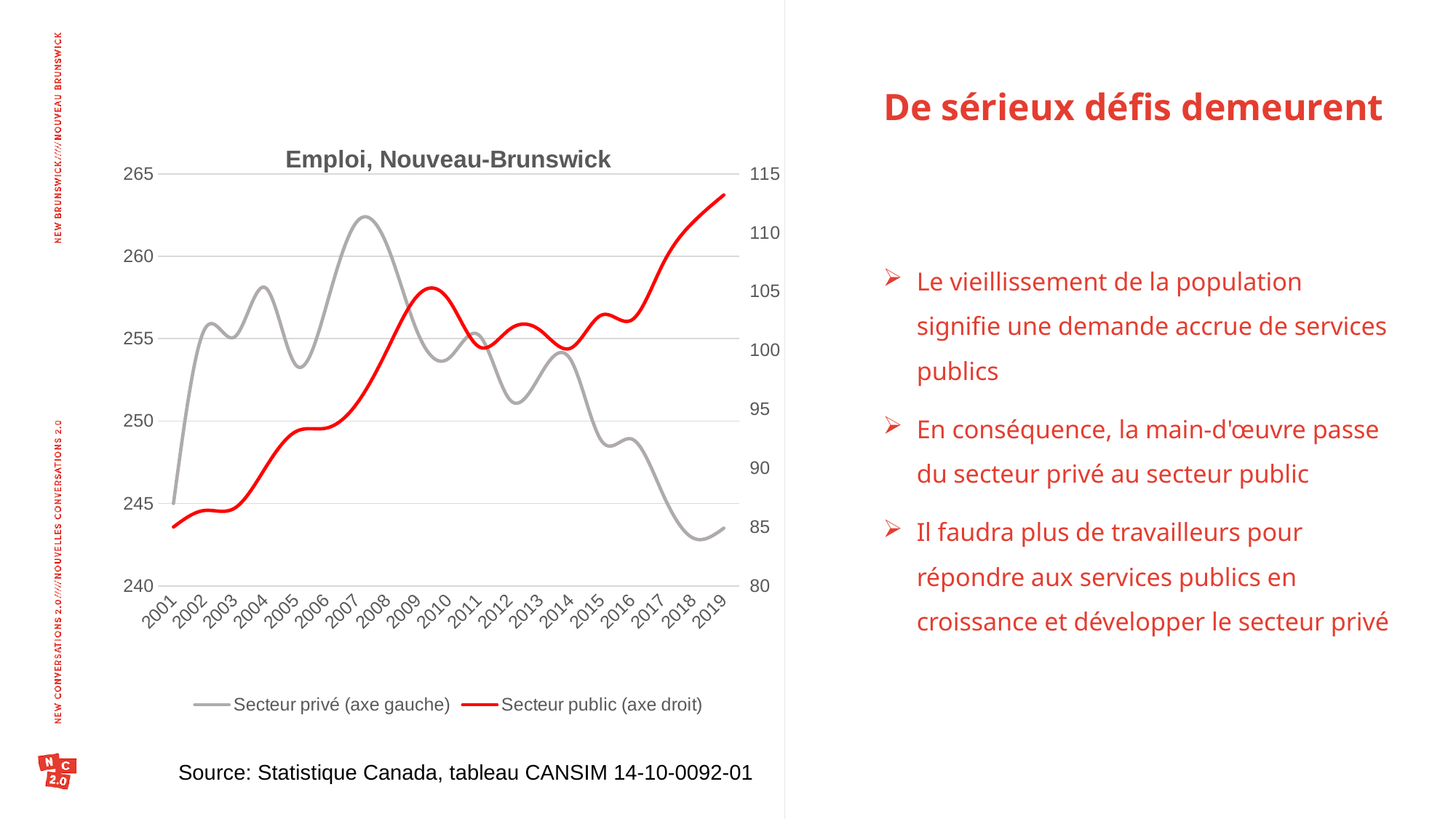
What kind of chart is shown on the slide? line chart In which year does the Secteur public series reach its lowest value? 2001 How many years are plotted along the x axis of the chart? 19 Which is larger for Secteur privé: the value in 2007 or the value in 2018? 2007 How many series does the legend of the chart list? 2 In which year does the Secteur privé series reach its highest value? 2007 Does the Secteur public series rise or fall overall from 2001 to 2019? rise Which series is drawn in red on the chart? Secteur public (axe droit) Is the value for Secteur privé in 2007 greater or less than 260? greater Is the value for Secteur privé in 2018 greater or less than 245? less Is the value for Secteur public in 2019 greater or less than 110? greater What is the title of the chart? Emploi, Nouveau-Brunswick